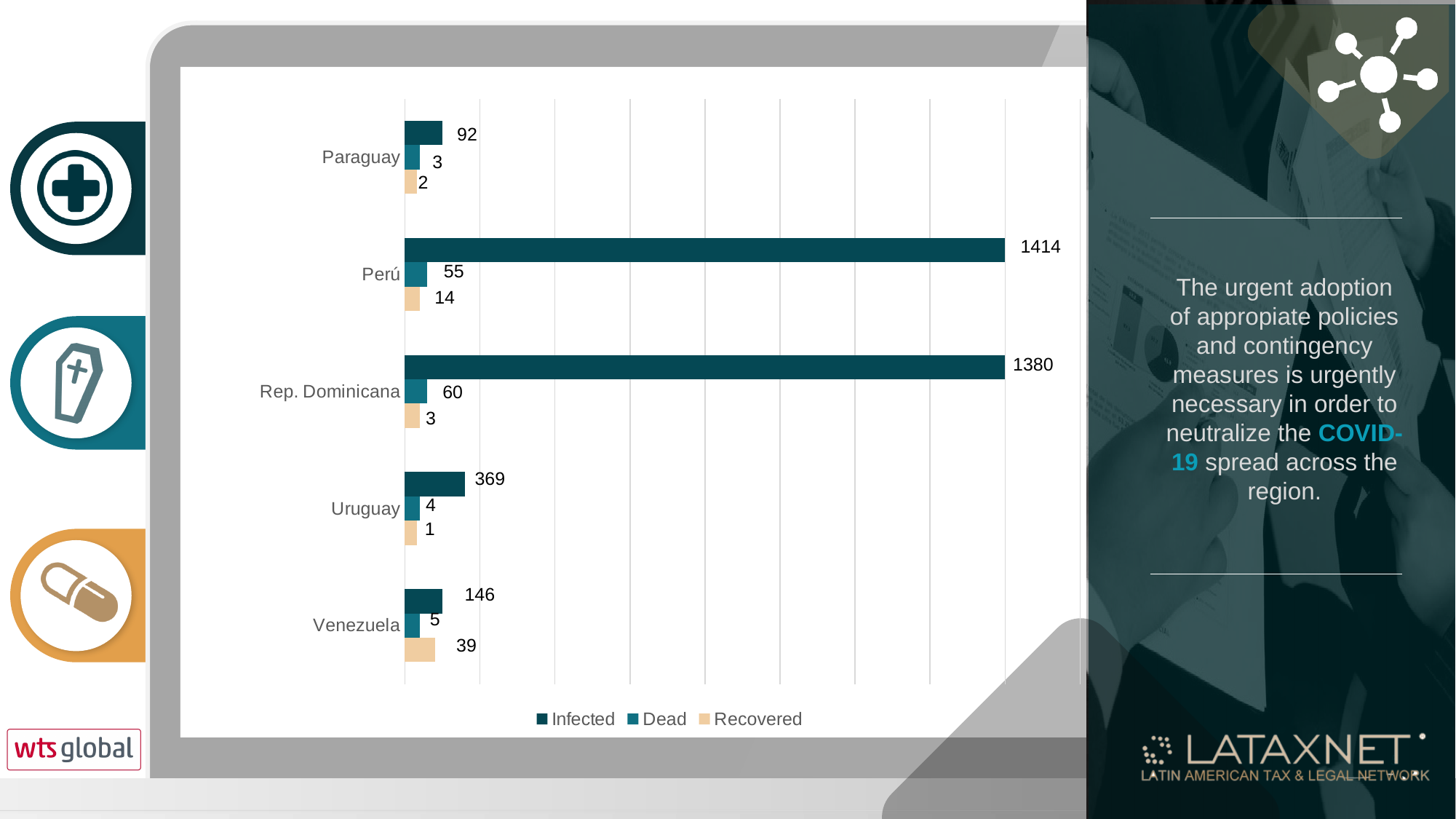
How many series does the legend list? 3 What is the Infected value for Uruguay? 369 What is the difference between the Infected values for Perú and Rep. Dominicana? 34 What is the Dead value for Rep. Dominicana? 60 Which country has the lowest Infected value? Paraguay What kind of chart is shown on the slide? Bar chart What is the Infected value for Perú? 1414 How many countries are shown on the chart? 5 Which is larger, the Dead value for Perú or the Dead value for Rep. Dominicana? Rep. Dominicana Which country has the highest Infected value? Perú What is the Recovered value for Venezuela? 39 Which series is shown in the light tan colour in the legend? Recovered